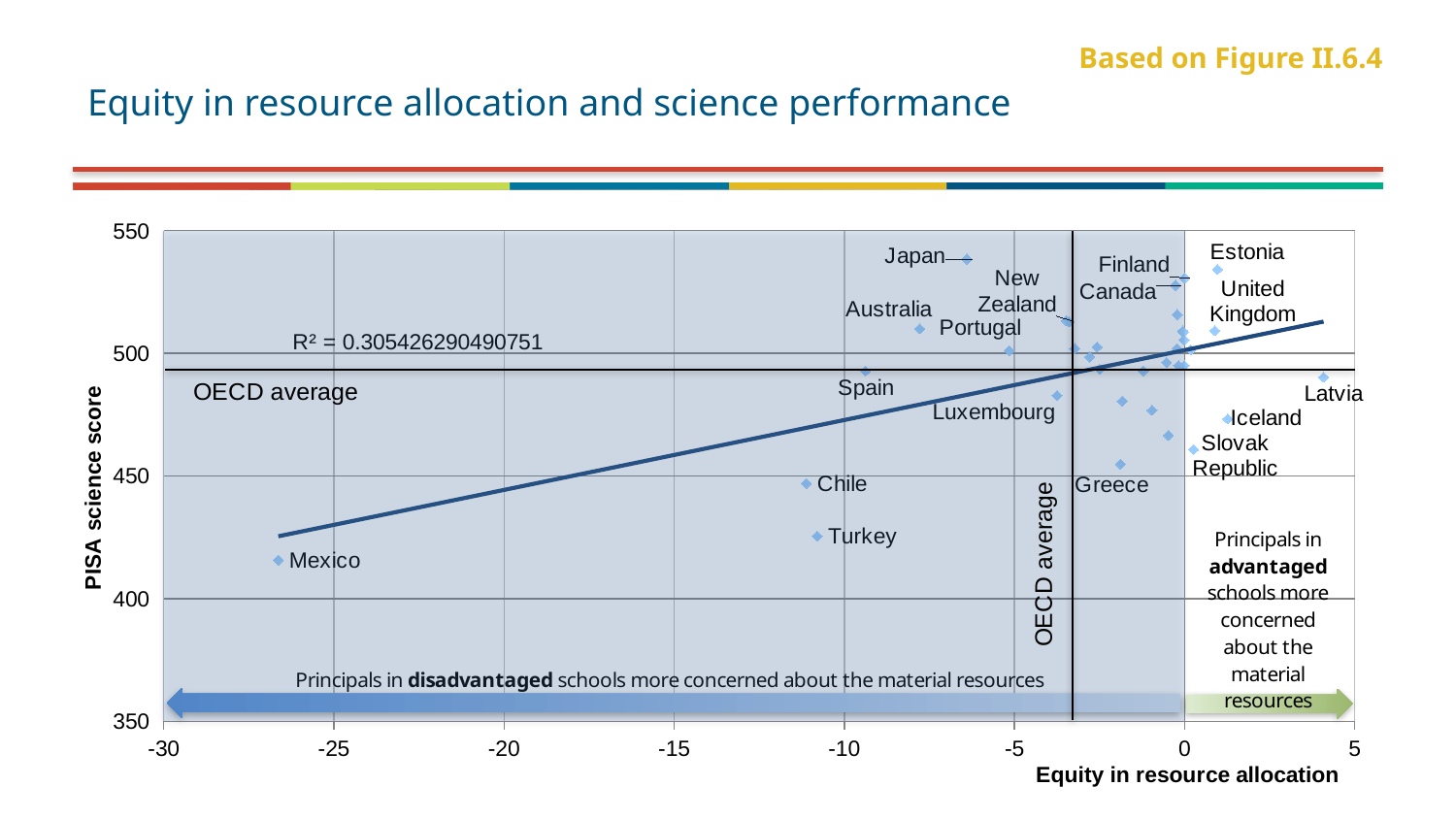
Which labelled country has the lowest (most negative) equity in resource allocation value? Mexico Which labelled country has the lowest PISA science score on the chart? Mexico Is the PISA science score for Greece greater or less than 500? less Which has the higher PISA science score, Japan or Chile? Japan What R² value is printed on the chart? R² = 0.305426290490751 What kind of chart is shown on the slide? Scatter chart Which labelled country has the highest equity in resource allocation value? Latvia Is the PISA science score for Mexico greater or less than 450? less Is the PISA science score for Japan greater or less than 500? greater Does the trend line show PISA science score rising or falling as equity in resource allocation increases? Rising